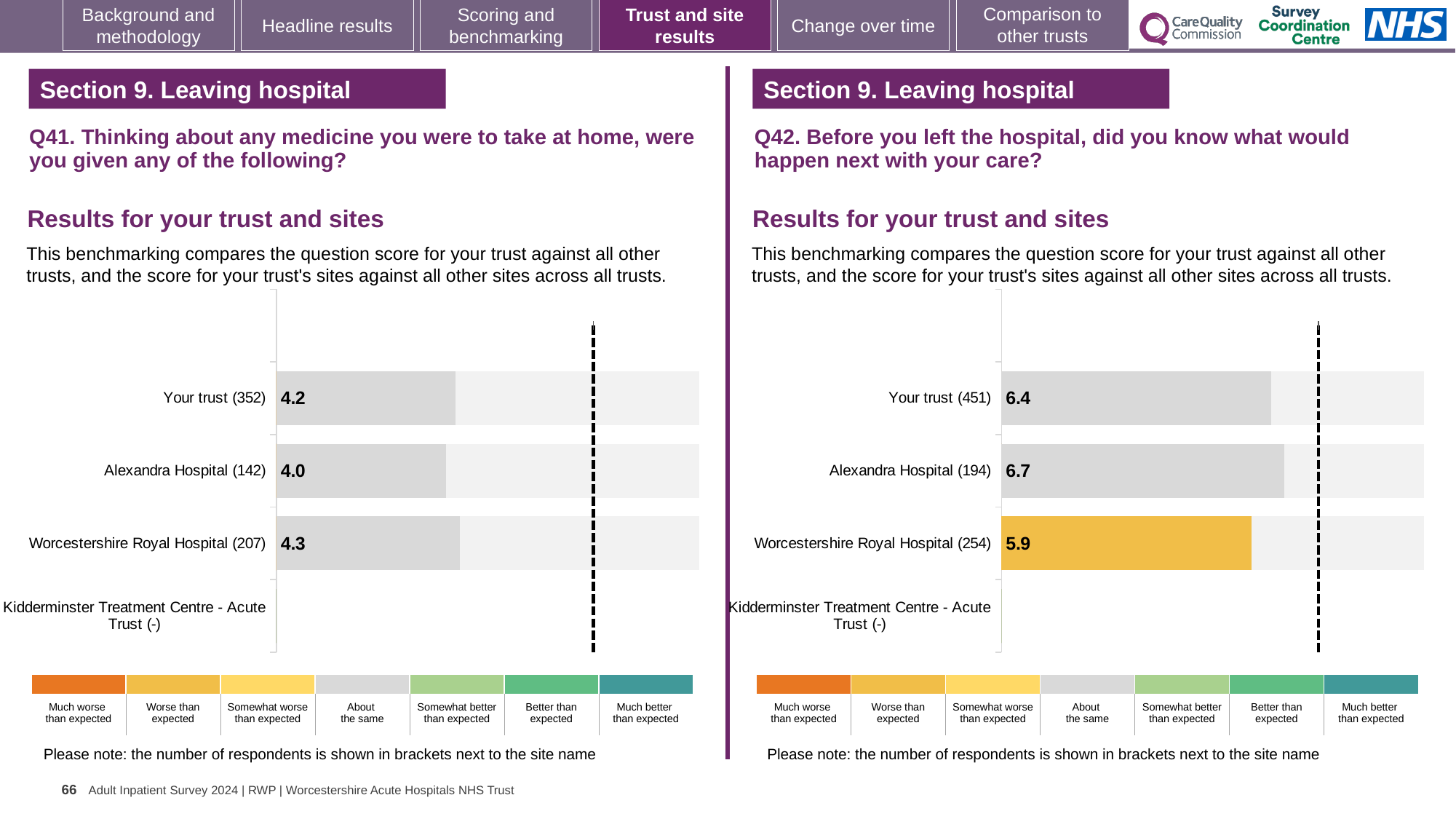
On the Q42 chart (right), how many respondents are shown for Alexandra Hospital? 194 On the Q42 chart (right), which site or trust has the lowest score? Worcestershire Royal Hospital On the Q42 chart (right), what is the score for Worcestershire Royal Hospital? 5.9 On the Q42 chart (right), what is the score for Your trust? 6.4 What kind of chart is used on the Q41 chart (left)? Bar chart On the Q41 chart (left), what is the score for Alexandra Hospital? 4.0 On the Q42 chart (right), which benchmark category does the colour of the Worcestershire Royal Hospital bar indicate? Worse than expected On the Q41 chart (left), what is the score for Your trust? 4.2 On the Q42 chart (right), what is the difference between the scores for Alexandra Hospital and Worcestershire Royal Hospital? 0.8 On the Q42 chart (right), which has the larger score, Alexandra Hospital or Your trust? Alexandra Hospital On the Q41 chart (left), which site or trust has the highest score? Worcestershire Royal Hospital On the Q41 chart (left), what is the difference between the scores for Worcestershire Royal Hospital and Alexandra Hospital? 0.3